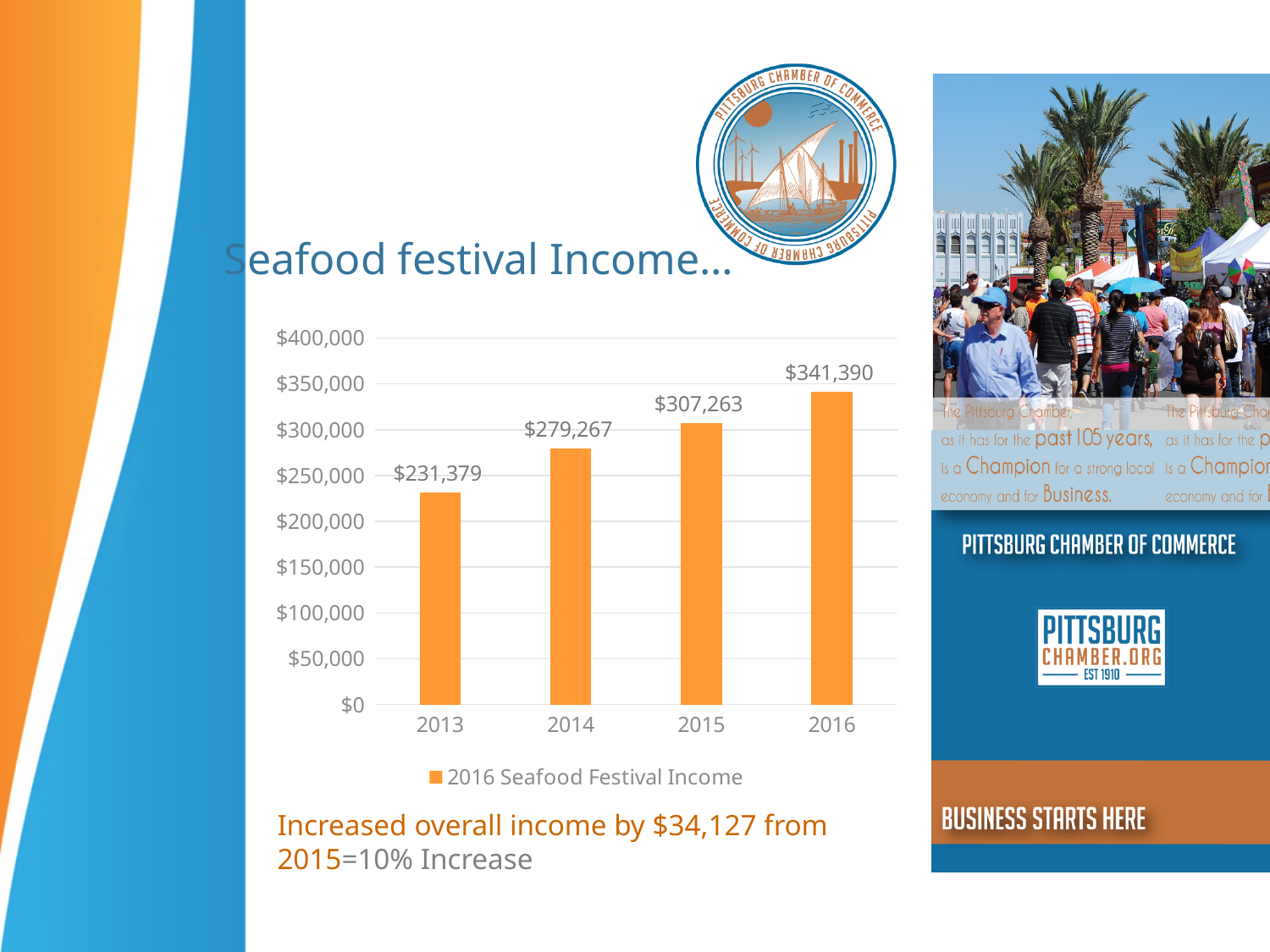
What is the difference between the 2016 and 2015 seafood festival income? $34,127 Does the seafood festival income rise or fall from 2013 to 2016? Rise What is the difference between the 2014 and 2013 seafood festival income? $47,888 What was the seafood festival income in 2013? $231,379 Is the seafood festival income for 2014 greater or less than $250,000? greater Which year had higher seafood festival income, 2014 or 2015? 2015 What was the seafood festival income in 2015? $307,263 Which year had the highest seafood festival income? 2016 How many years are shown on the chart? 4 Which year had the lowest seafood festival income? 2013 What was the seafood festival income in 2016? $341,390 What type of chart is shown on the slide? Bar chart